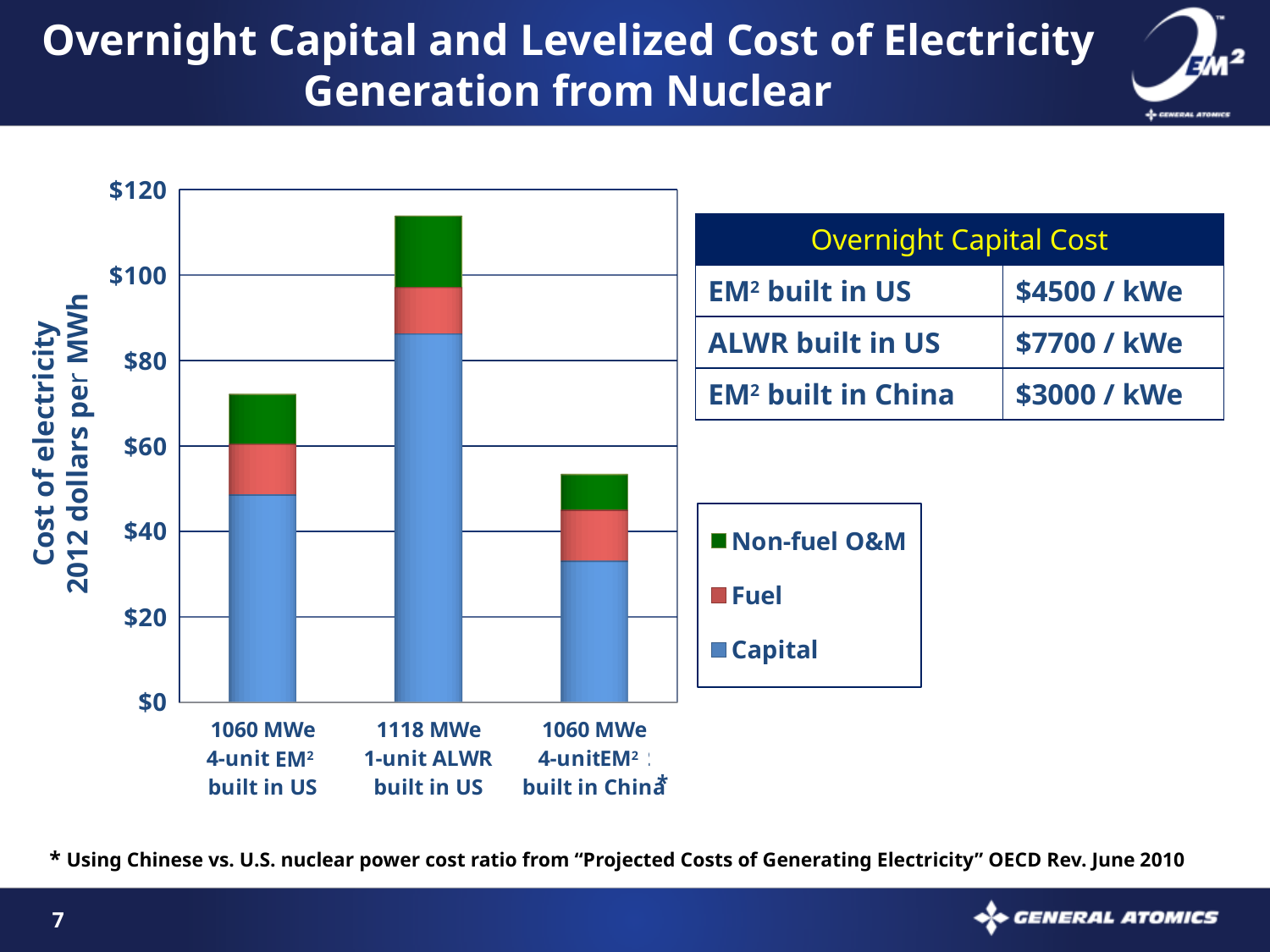
Which legend entry is shown in green? Non-fuel O&M Which plant configuration has the highest total cost of electricity? 1118 MWe 1-unit ALWR built in US Is the total cost of electricity for the 1060 MWe 4-unit EM² built in China greater or less than $60 per MWh? less Is the total cost of electricity for the 1060 MWe 4-unit EM² built in US greater or less than $60 per MWh? greater Is the Capital portion of the 1118 MWe 1-unit ALWR built in US bar greater or less than $80 per MWh? greater Which has a larger total cost of electricity: the 4-unit EM² built in US or the 4-unit EM² built in China? 4-unit EM² built in US How many series does the chart legend list? 3 How many bars (plant configurations) are plotted in the chart? 3 What kind of chart is shown on the slide? Stacked bar chart Which plant configuration has the lowest total cost of electricity? 1060 MWe 4-unit EM² built in China